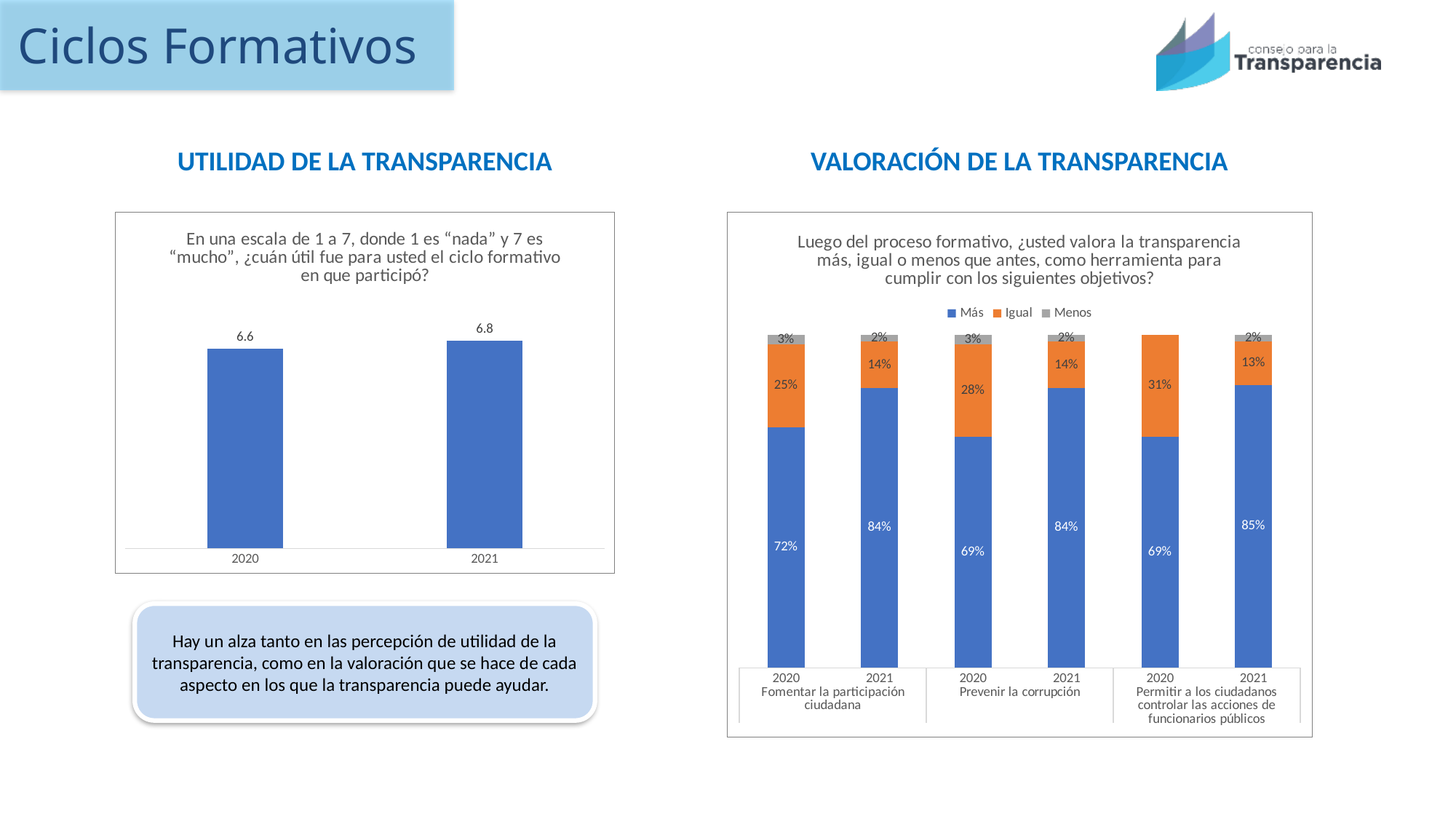
In the UTILIDAD DE LA TRANSPARENCIA chart, what is the difference between the 2021 and 2020 values? 0.2 In the UTILIDAD DE LA TRANSPARENCIA chart, which year has the higher value? 2021 In the UTILIDAD DE LA TRANSPARENCIA chart, what is the value for 2020? 6.6 In the VALORACIÓN DE LA TRANSPARENCIA chart, what is the 'Más' value for Prevenir la corrupción in 2021? 84% In the VALORACIÓN DE LA TRANSPARENCIA chart, what is the 'Igual' value for Permitir a los ciudadanos controlar las acciones de funcionarios públicos in 2020? 31% In the VALORACIÓN DE LA TRANSPARENCIA chart, which bar has the highest 'Más' value? Permitir a los ciudadanos controlar las acciones de funcionarios públicos, 2021 In the VALORACIÓN DE LA TRANSPARENCIA chart, what is the difference between the 'Más' values for Fomentar la participación ciudadana in 2021 and 2020? 12% In the UTILIDAD DE LA TRANSPARENCIA chart, how many bars are plotted? 2 In the VALORACIÓN DE LA TRANSPARENCIA chart, how many series does the legend list? 3 In the UTILIDAD DE LA TRANSPARENCIA chart, what is the value for 2021? 6.8 What kind of chart is the VALORACIÓN DE LA TRANSPARENCIA chart? Stacked bar chart In the VALORACIÓN DE LA TRANSPARENCIA chart, is the 'Más' value for Fomentar la participación ciudadana larger in 2020 or 2021? 2021